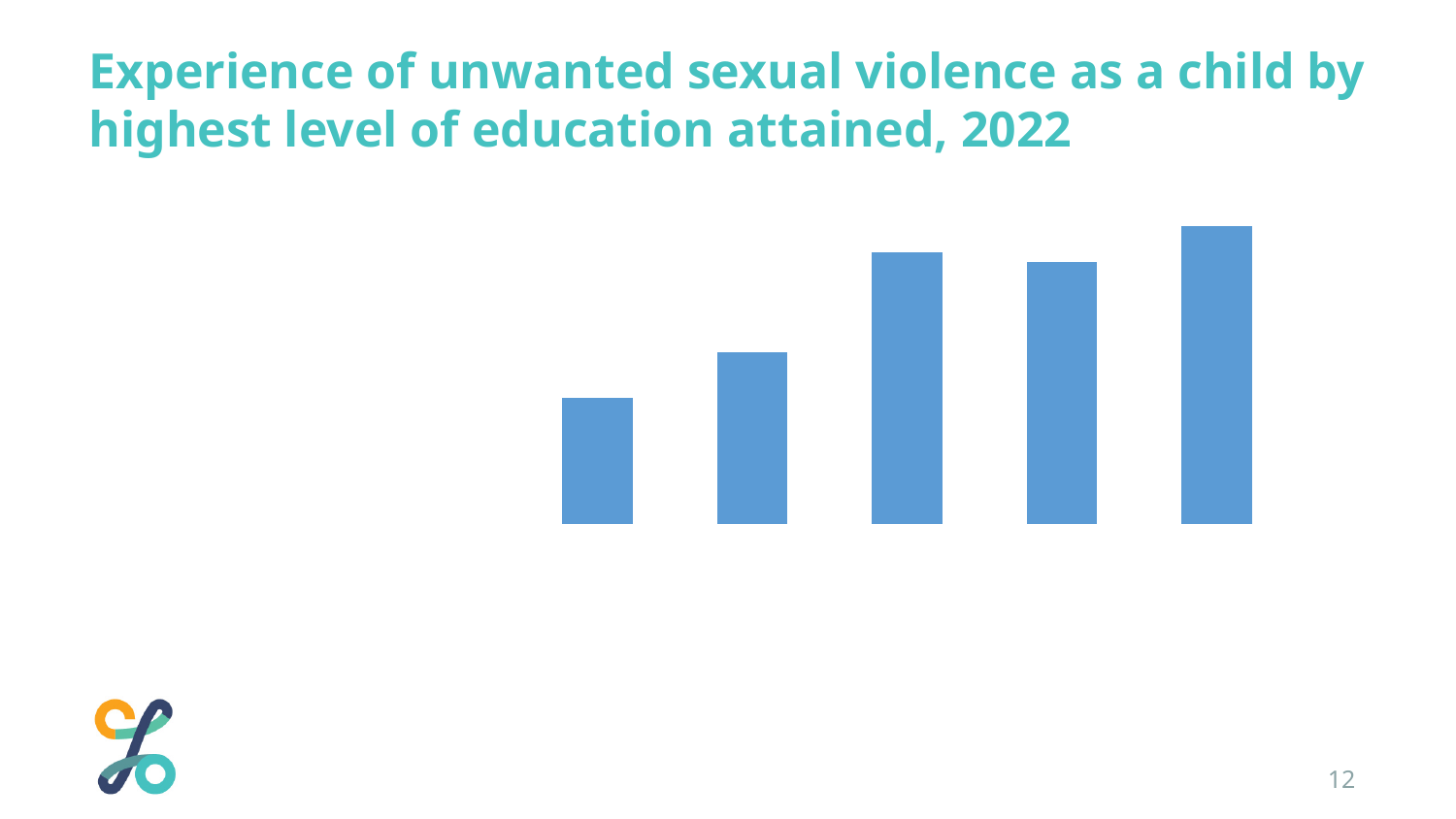
What is the title of the slide containing the chart? Experience of unwanted sexual violence as a child by highest level of education attained, 2022 Is the rightmost bar taller or shorter than the leftmost bar? taller What kind of chart is shown on the slide? bar chart What colour are the bars in the chart? blue Is the second bar from the left taller or shorter than the first bar? taller How many bars does the chart show? 5 Which bar is the tallest in the chart, counting from the left? the fifth (rightmost) bar Which bar is the shortest in the chart, counting from the left? the first (leftmost) bar Do the bar heights generally rise or fall from left to right across the chart? rise